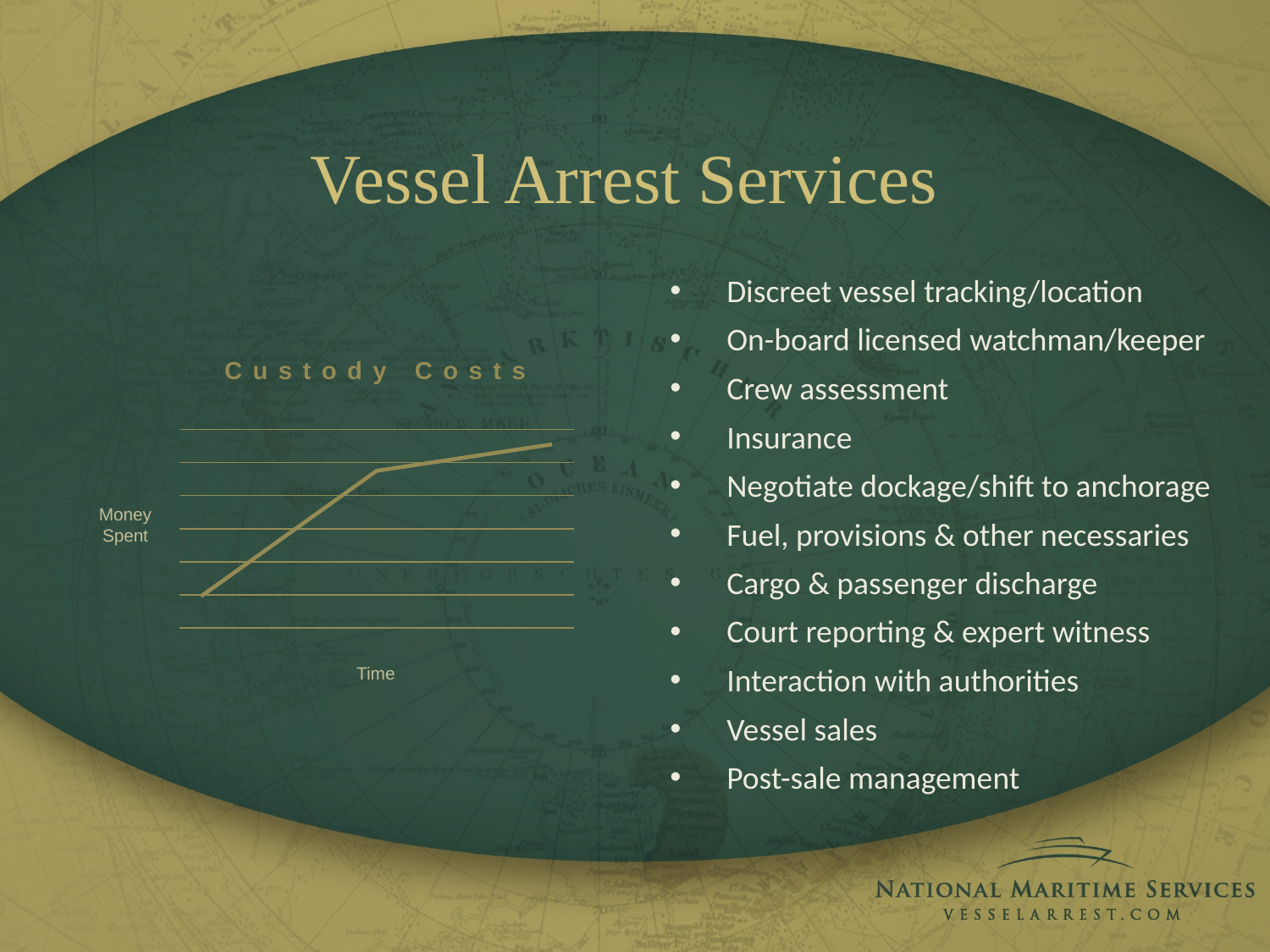
In the Custody Costs chart, is money spent higher at the start or at the end of the time axis? at the end What is the label of the vertical axis of the Custody Costs chart? Money Spent What is the title of the chart on the slide? Custody Costs Do the values in the Custody Costs chart rise or fall along the x axis? rise What kind of chart is shown on the slide? line chart What is the label of the horizontal axis of the Custody Costs chart? Time